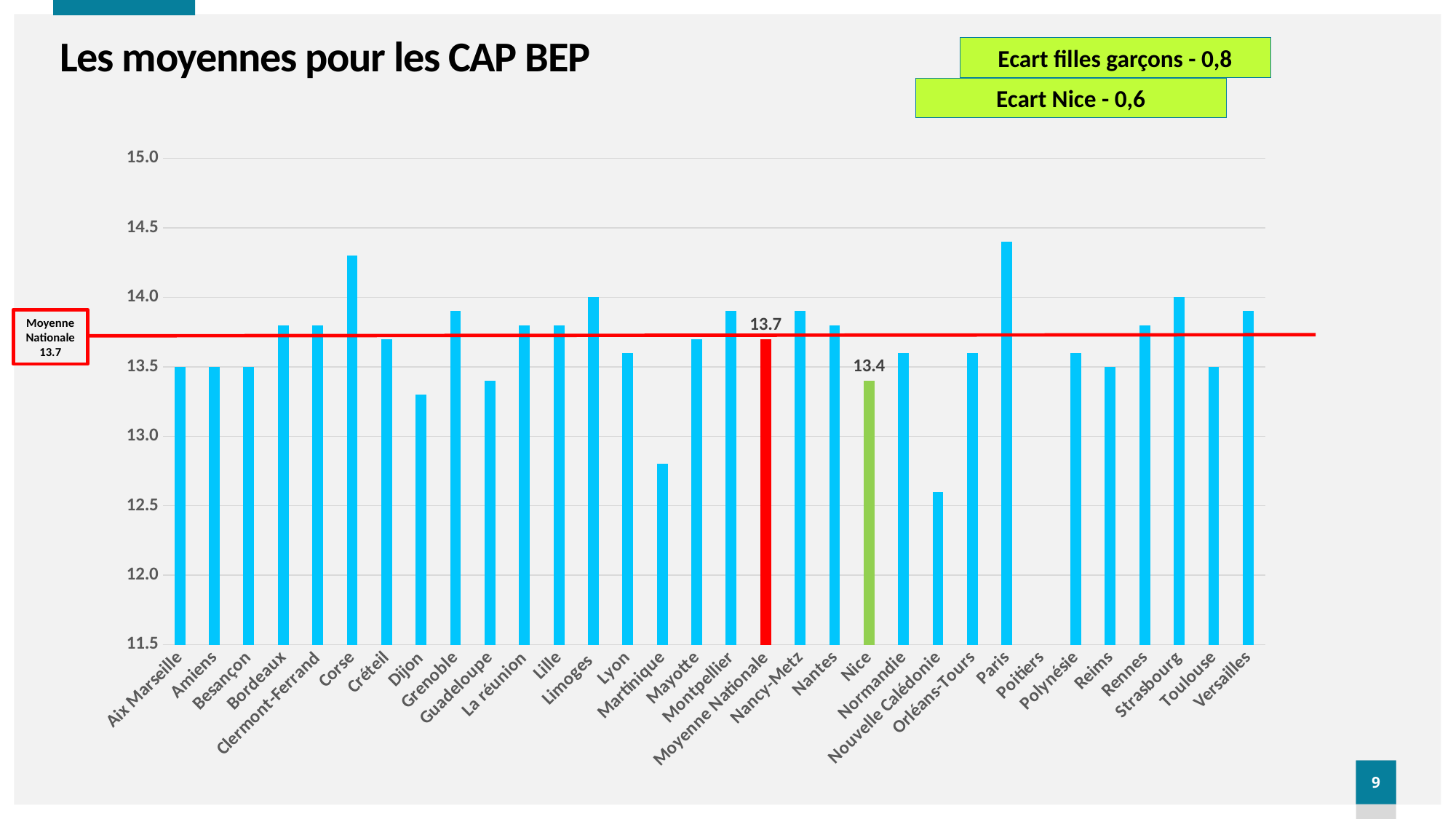
What is the value labelled on the Nice bar? 13.4 What type of chart is shown on the slide? Bar chart Is the value for Corse greater or less than 14.0? greater What is the value labelled on the Moyenne Nationale bar? 13.7 Is the value for Martinique greater or less than 13.0? less What is the difference between the Moyenne Nationale value (13.7) and the Nice value (13.4)? 0.3 How many categories are listed on the x axis? 32 Which is larger, the value for Corse or the value for Paris? Paris What colour is the Nice bar? Green Among the bars plotted, which category has the lowest bar? Nouvelle Calédonie Is the value for Dijon greater or less than 13.5? less Which category has the highest bar? Paris